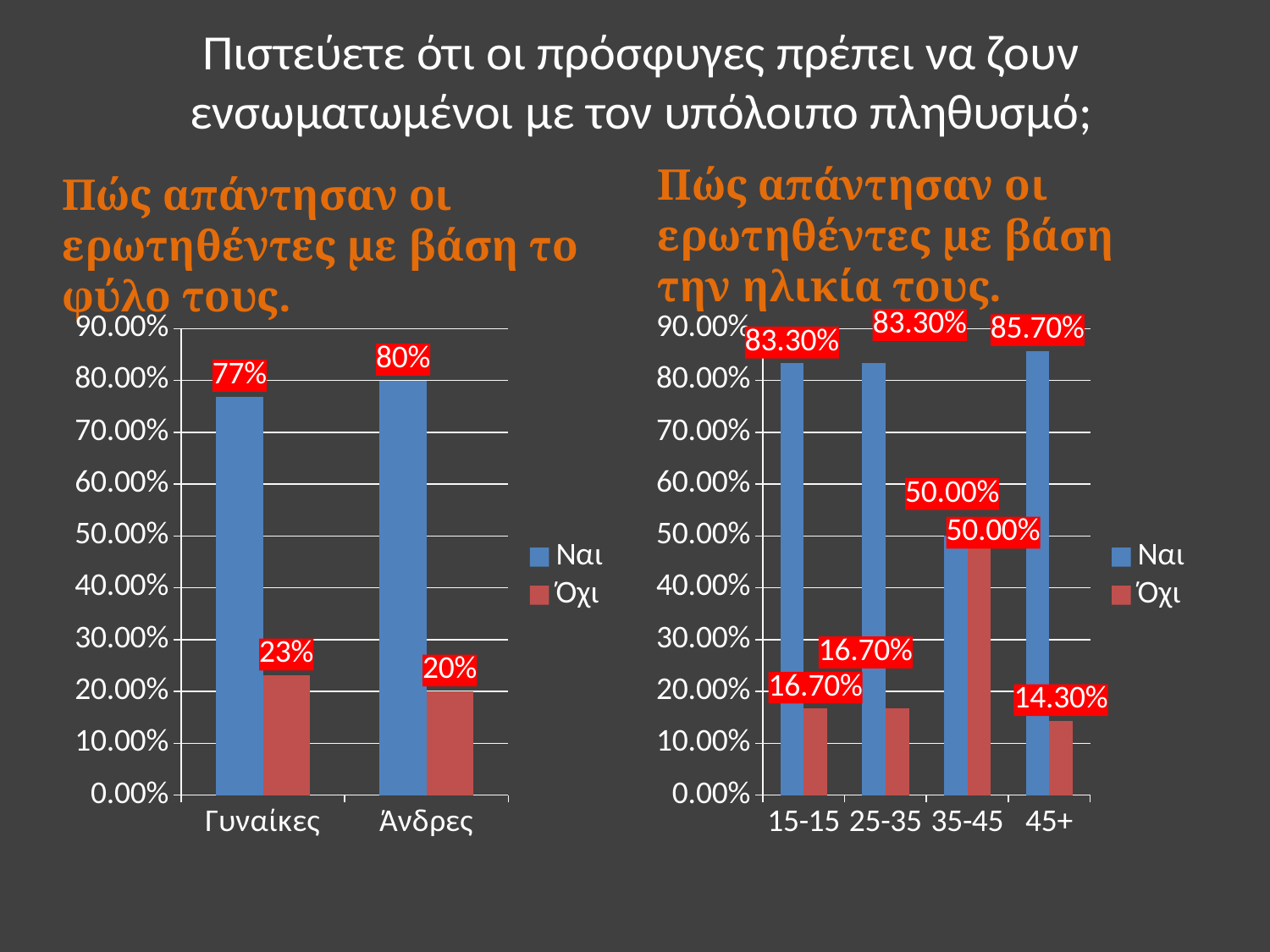
In the left chart (by gender), which category has the higher Όχι value, Γυναίκες or Άνδρες? Γυναίκες In the right chart (by age), what is the value of Όχι for the 35-45 group? 50.00% What kind of chart is the right chart (by age)? Bar chart In the left chart (by gender), how many series does the legend list? 2 In the left chart (by gender), what is the value of Ναι for Γυναίκες? 77% In the right chart (by age), what is the value of Ναι for the 45+ group? 85.70% In the right chart (by age), which age group has the highest Ναι value? 45+ In the right chart (by age), how many age groups are shown on the x axis? 4 In the right chart (by age), which age group has the lowest Όχι value? 45+ In the left chart (by gender), what is the difference between the Ναι values for Άνδρες and Γυναίκες? 3% In the right chart (by age), what is the difference between the Ναι and Όχι values for the 15-15 group? 66.60% In the left chart (by gender), what is the value of Όχι for Άνδρες? 20%